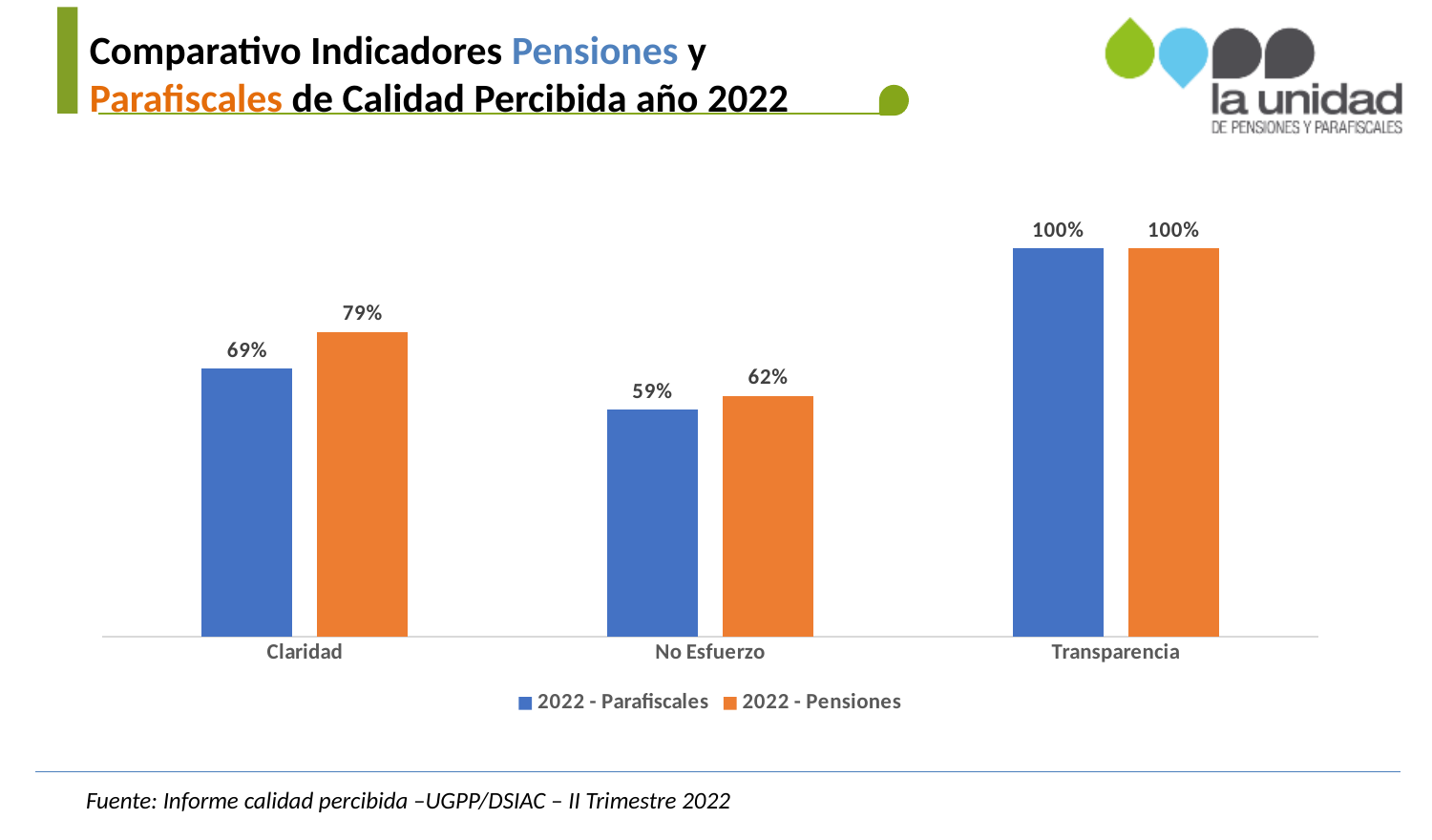
In the No Esfuerzo category, which series has the larger value, 2022 - Parafiscales or 2022 - Pensiones? 2022 - Pensiones What is the value for 2022 - Pensiones in the Claridad category? 79% How many categories are shown on the x axis? 3 What is the value for 2022 - Pensiones in the Transparencia category? 100% What is the value for 2022 - Parafiscales in the No Esfuerzo category? 59% How many series does the legend list? 2 What kind of chart is shown on the slide? Bar chart Which category has the lowest value for 2022 - Parafiscales? No Esfuerzo Which category has the highest value for 2022 - Pensiones? Transparencia What is the difference between the 2022 - Pensiones and 2022 - Parafiscales values in the Claridad category? 10% What is the value for 2022 - Parafiscales in the Claridad category? 69% What is the value for 2022 - Pensiones in the No Esfuerzo category? 62%